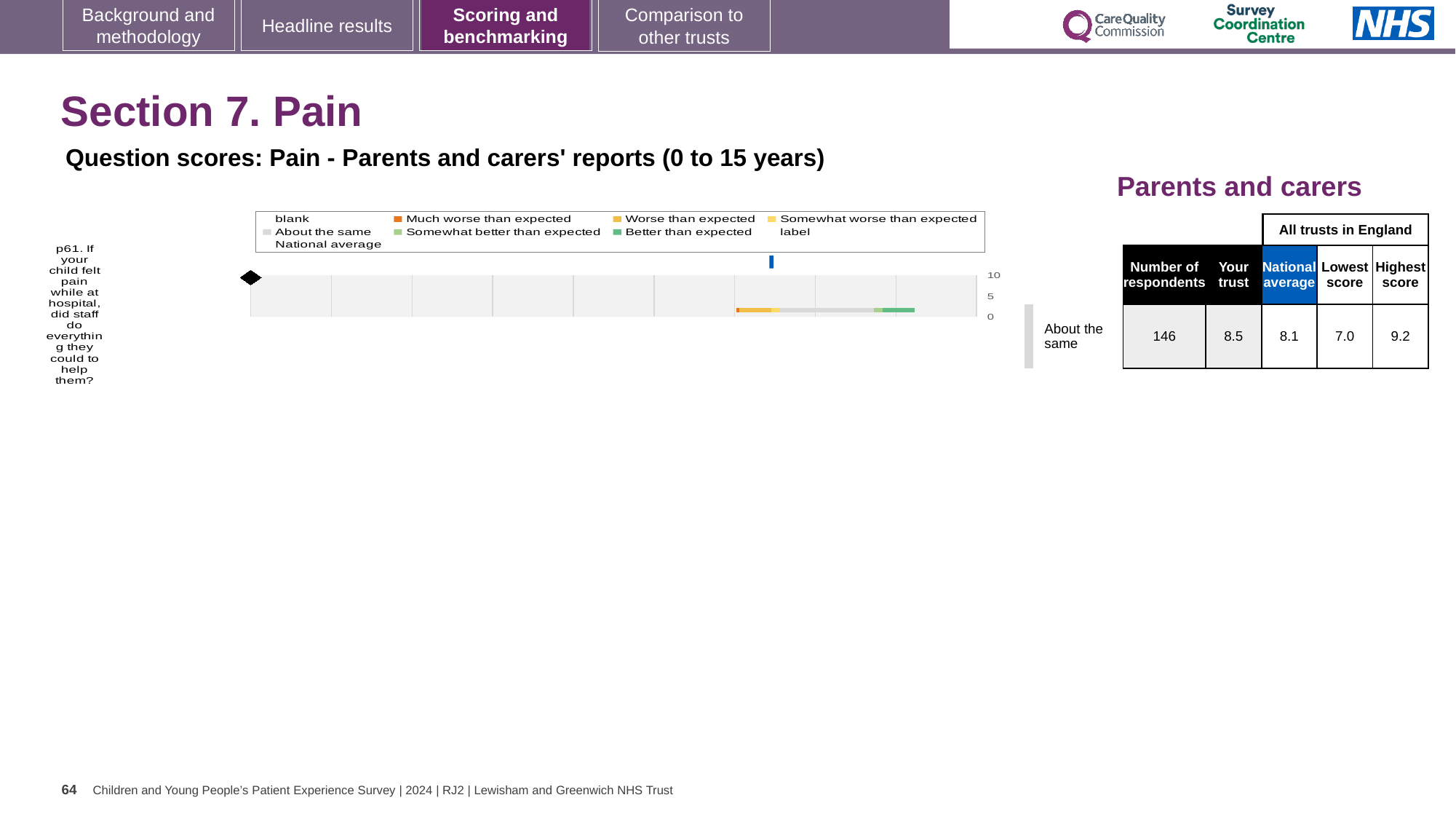
How many respondents answered question p61? 146 How many survey questions are plotted in the chart? 1 What is the difference between the 'Your trust' score and the national average for question p61? 0.4 Is the 'Your trust' score for question p61 greater or less than 5? greater What is the 'Your trust' score for question p61? 8.5 What kind of chart is used to show the p61 question score? bar chart Which is larger for question p61, the 'Your trust' score or the national average? Your trust What is the highest value shown on the chart's score axis? 10 What is the lowest score among all trusts in England for question p61? 7.0 Which legend entry does the blue marker on the chart represent? National average What is the highest score among all trusts in England for question p61? 9.2 What is the national average score for question p61? 8.1